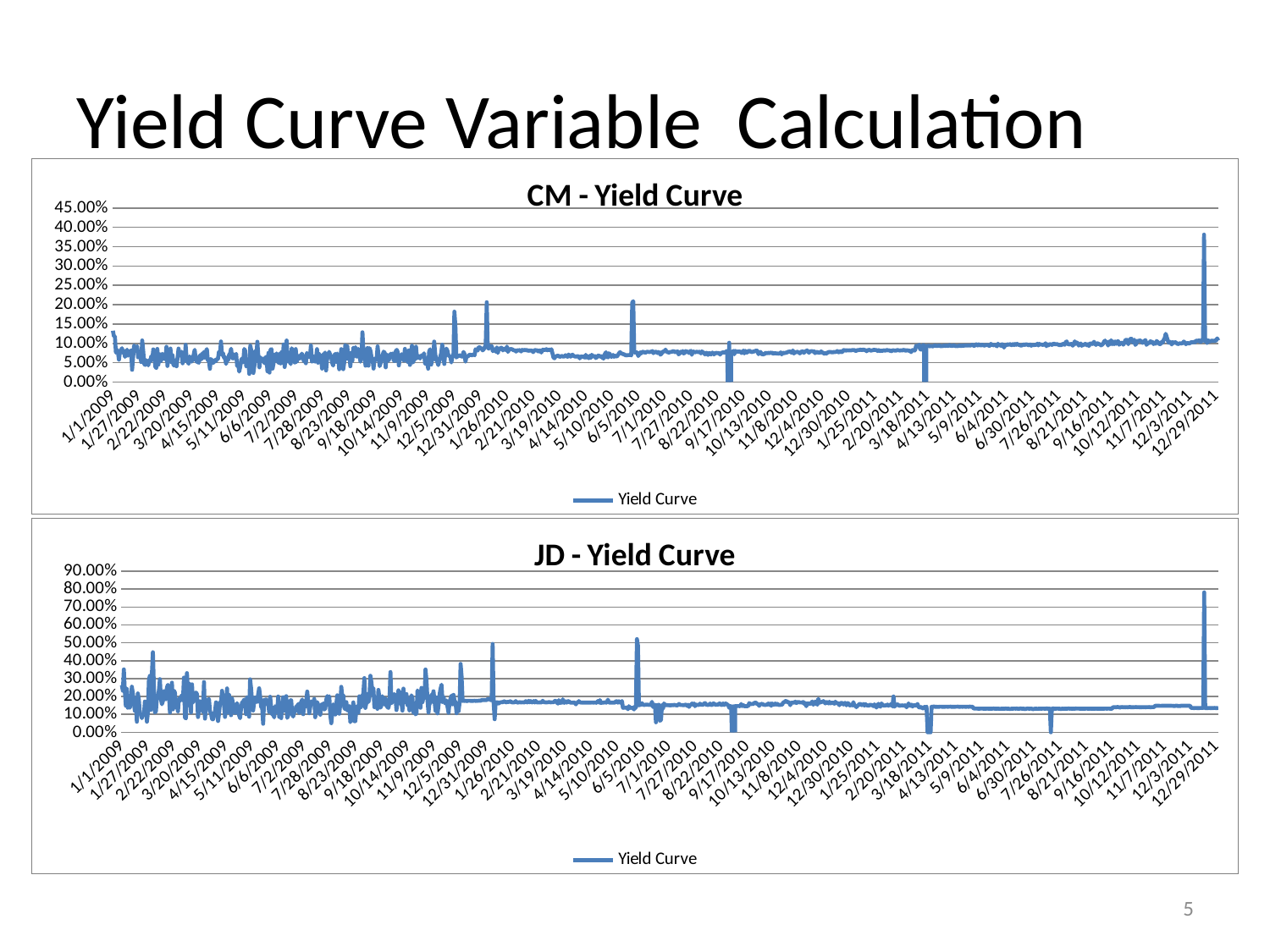
What is the legend entry shown on the JD - Yield Curve chart? Yield Curve In the CM - Yield Curve chart, is the highest value on the line greater or less than 35.00%? greater What is the title of the top chart on the slide? CM - Yield Curve What kind of chart is the JD - Yield Curve chart? line chart In the JD - Yield Curve chart, is the highest value on the line greater or less than 80.00%? less How many series does the legend of the CM - Yield Curve chart list? 1 In the JD - Yield Curve chart, is the highest value on the line greater or less than 70.00%? greater What kind of chart is the CM - Yield Curve chart? line chart What is the highest value shown on the y axis of the JD - Yield Curve chart? 90.00%